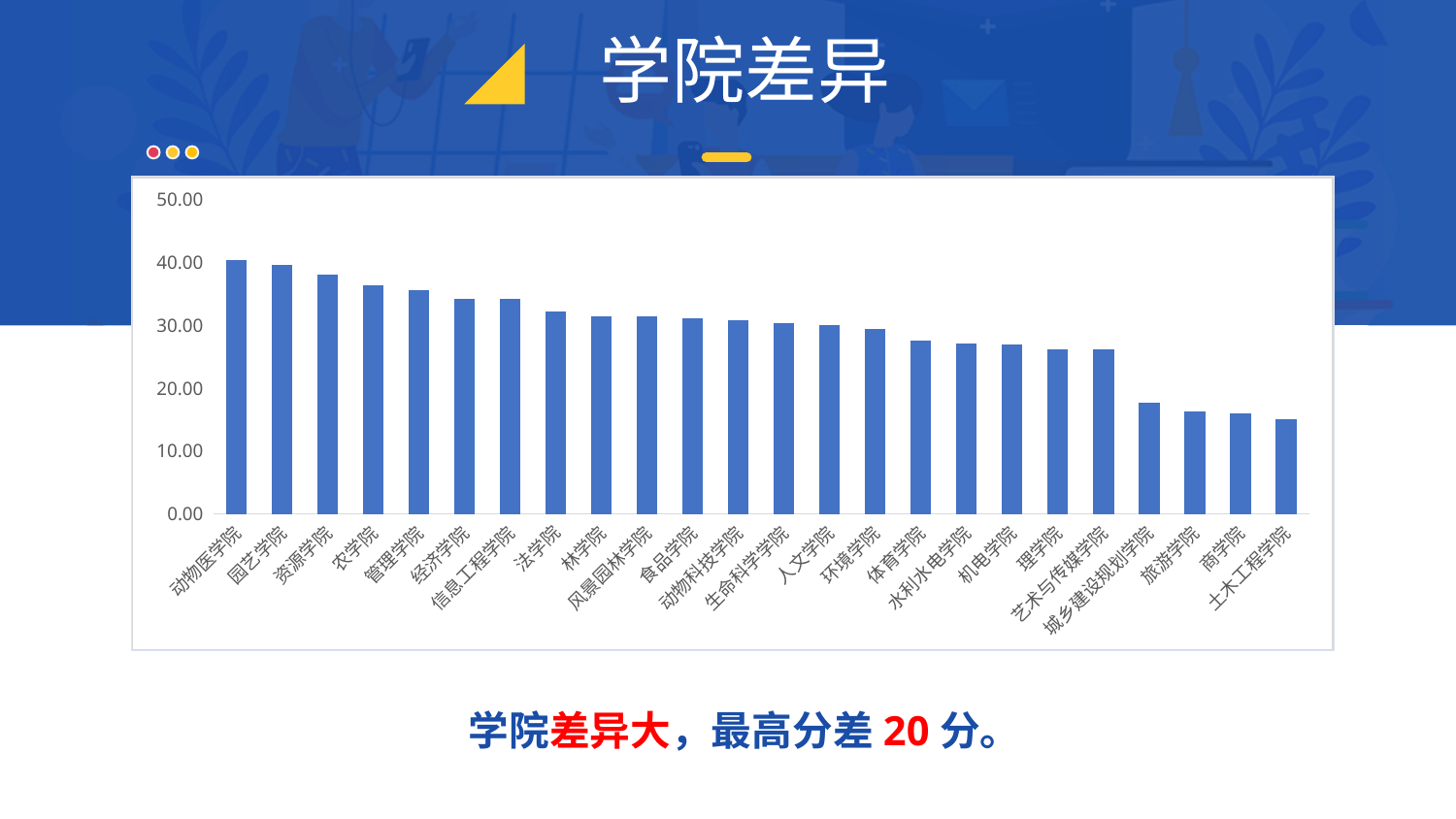
Is the value for 城乡建设规划学院 greater or less than 20? less Which has the larger value, 农学院 or 旅游学院? 农学院 Which has the larger value, 商学院 or 人文学院? 人文学院 Is the value for 土木工程学院 greater or less than 10? greater Which college has the highest value in the chart? 动物医学院 What kind of chart is shown on the slide? bar chart Which college has the lowest value in the chart? 土木工程学院 Is the value for 资源学院 greater or less than 30? greater How many colleges (categories) are plotted in the chart? 24 Do the values rise or fall moving from left to right along the x axis? fall What is the title of the slide containing the chart? 学院差异